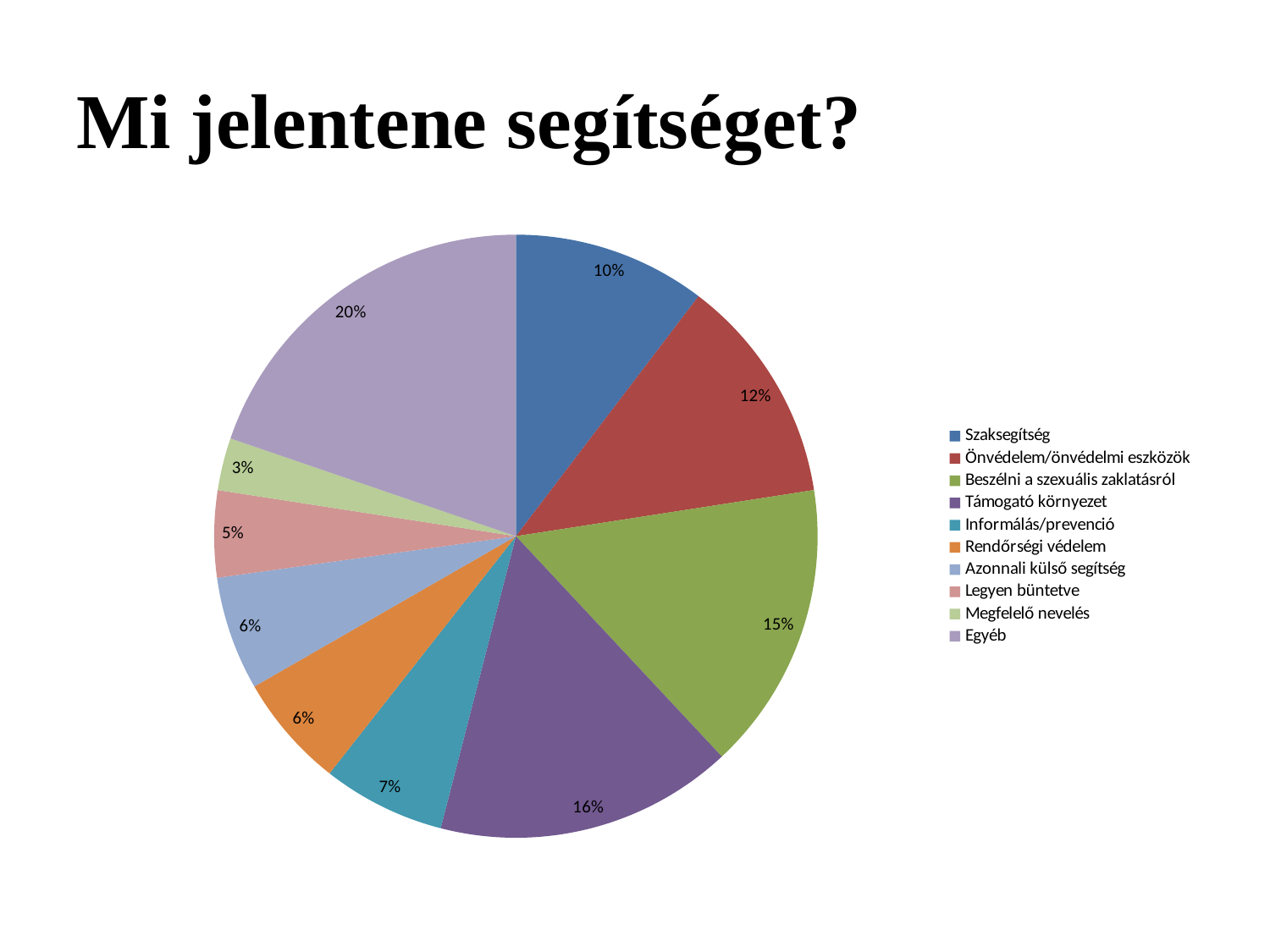
What is the title of the slide containing the chart? Mi jelentene segítséget? What share of the pie does Szaksegítség have? 10% What is the difference in percentage points between Beszélni a szexuális zaklatásról and Önvédelem/önvédelmi eszközök? 3 Which is larger, the slice for Támogató környezet or the slice for Legyen büntetve? Támogató környezet Which category has the smallest slice of the pie? Megfelelő nevelés How many categories does the pie chart show? 10 What share of the pie does Megfelelő nevelés have? 3% What share of the pie does Egyéb have? 20% What kind of chart is shown on the slide? Pie chart Which category has the largest slice of the pie? Egyéb